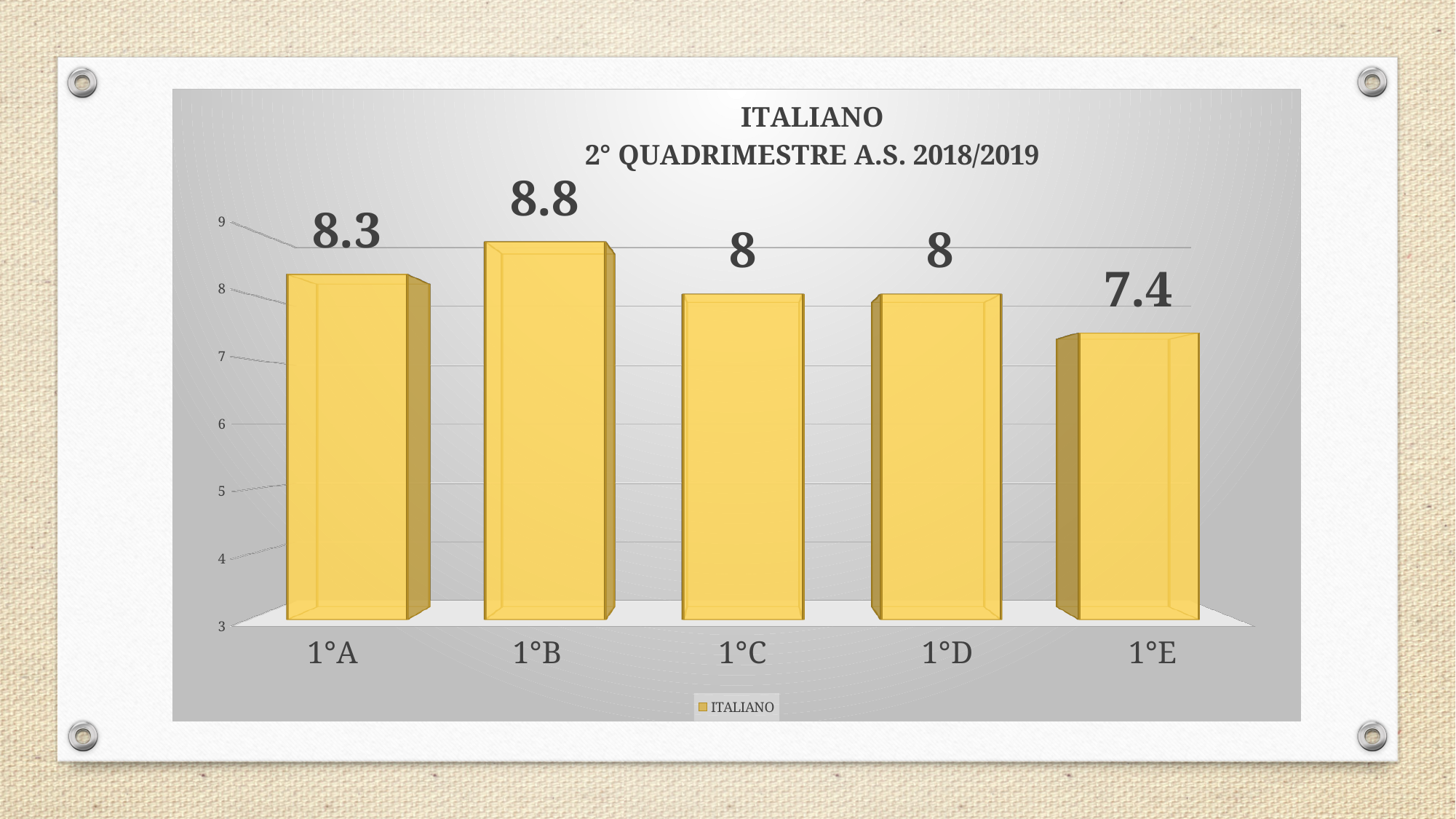
Which class has the lowest value? 1°E What is the value for 1°E? 7.4 How many series does the legend list? 1 What is the value for 1°C? 8 What is the value for 1°A? 8.3 What is the title of the chart? ITALIANO 2° QUADRIMESTRE A.S. 2018/2019 Which is larger, the value for 1°A or the value for 1°C? 1°A What is the difference between the values for 1°A and 1°D? 0.3 What kind of chart is shown on the slide? bar chart How many classes are shown on the x axis? 5 Which class has the highest value? 1°B What is the difference between the values for 1°B and 1°E? 1.4